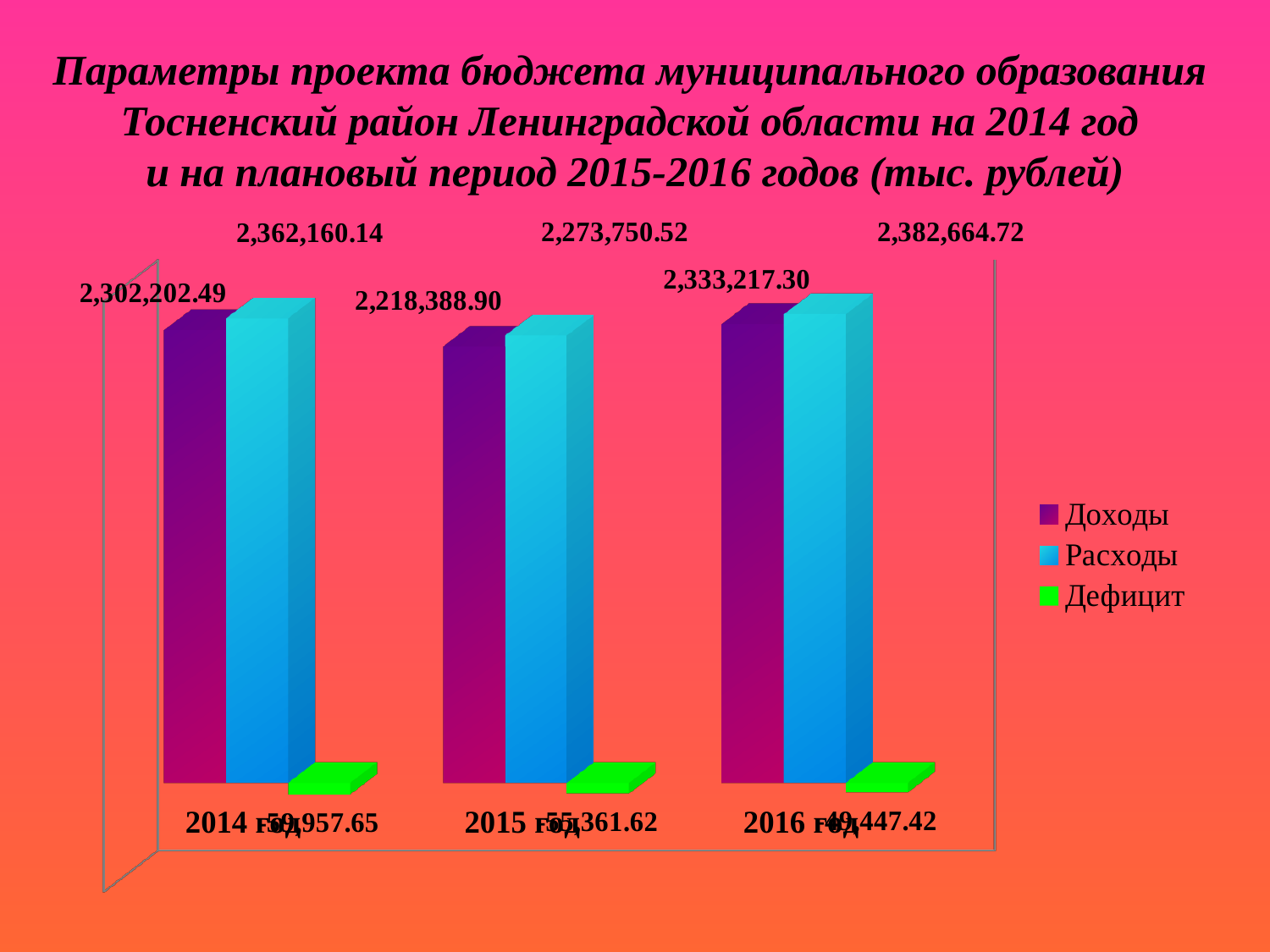
Which is larger for 2016 год, Доходы or Расходы? Расходы How many years are shown on the x axis? 3 What is the difference between Расходы and Доходы for 2014 год? 59,957.65 Which year has the lowest value of Доходы? 2015 год What is the value of Доходы for 2014 год? 2,302,202.49 How many series does the legend list? 3 What kind of chart is shown on the slide? Bar chart What is the value of Дефицит for 2015 год? -55,361.62 What is the value of Расходы for 2016 год? 2,382,664.72 Which year has the highest value of Расходы? 2016 год What is the value of Расходы for 2015 год? 2,273,750.52